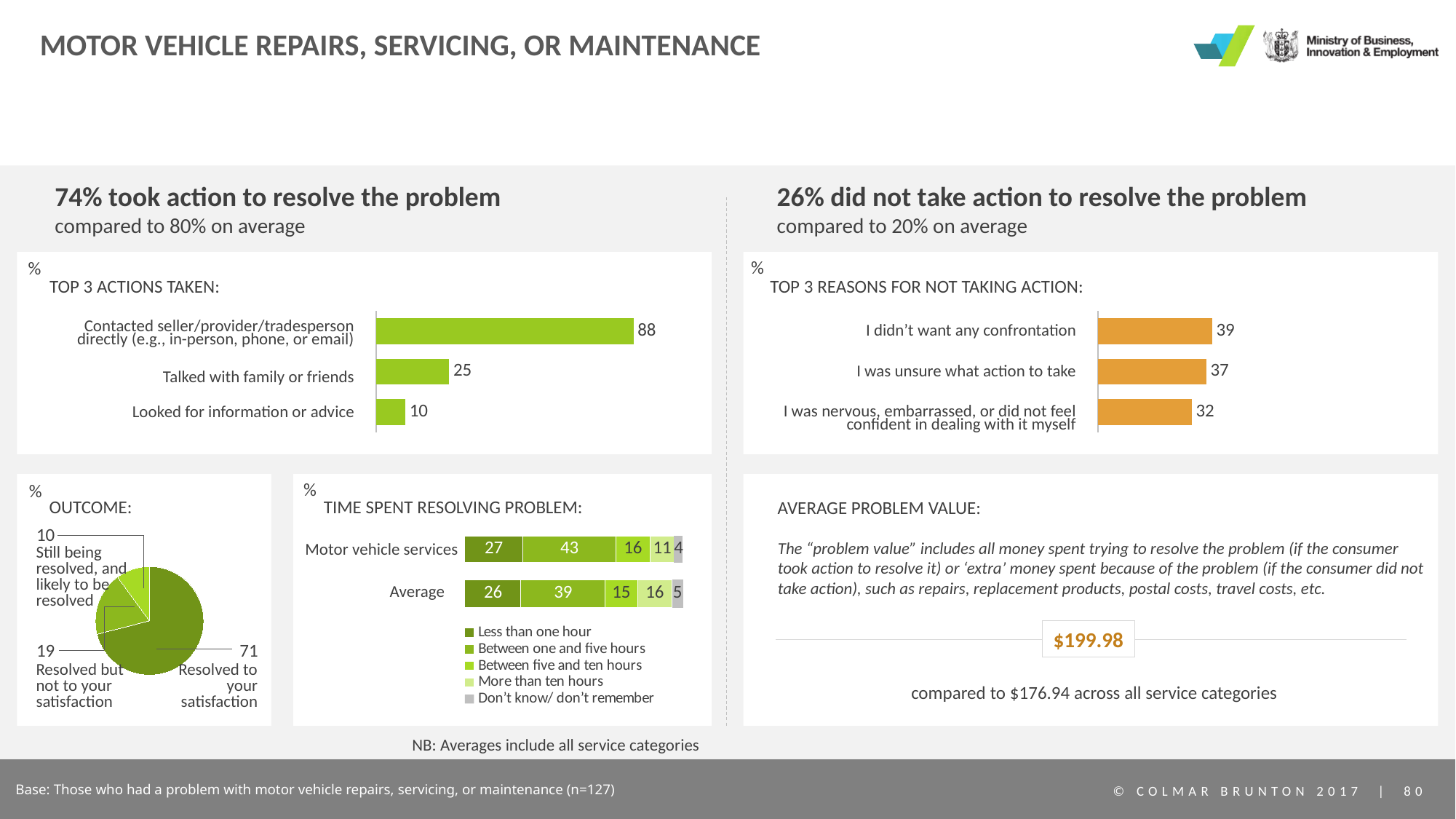
In the 'Top 3 actions taken' chart, which action has the highest value? Contacted seller/provider/tradesperson directly (e.g., in-person, phone, or email) In the 'Top 3 reasons for not taking action' chart, which reason has the lowest value? I was nervous, embarrassed, or did not feel confident in dealing with it myself In the 'Time spent resolving problem' chart, what is the difference between the 'Less than one hour' values for 'Motor vehicle services' and 'Average'? 1 What kind of chart is the 'Outcome' chart? Pie chart In the 'Time spent resolving problem' chart, what is the 'Between one and five hours' value for 'Motor vehicle services'? 43 In the 'Top 3 actions taken' chart, what is the difference between 'Contacted seller/provider/tradesperson directly' and 'Looked for information or advice'? 78 In the 'Top 3 reasons for not taking action' chart, which is larger: 'I didn't want any confrontation' or 'I was unsure what action to take'? I didn't want any confrontation In the 'Top 3 reasons for not taking action' chart, what is the value for 'I was unsure what action to take'? 37 In the 'Top 3 actions taken' chart, what is the value for 'Talked with family or friends'? 25 In the 'Outcome' pie chart, what is the value for 'Resolved but not to your satisfaction'? 19 How many series does the legend of the 'Time spent resolving problem' chart list? 5 In the 'Outcome' pie chart, what share is 'Resolved to your satisfaction'? 71